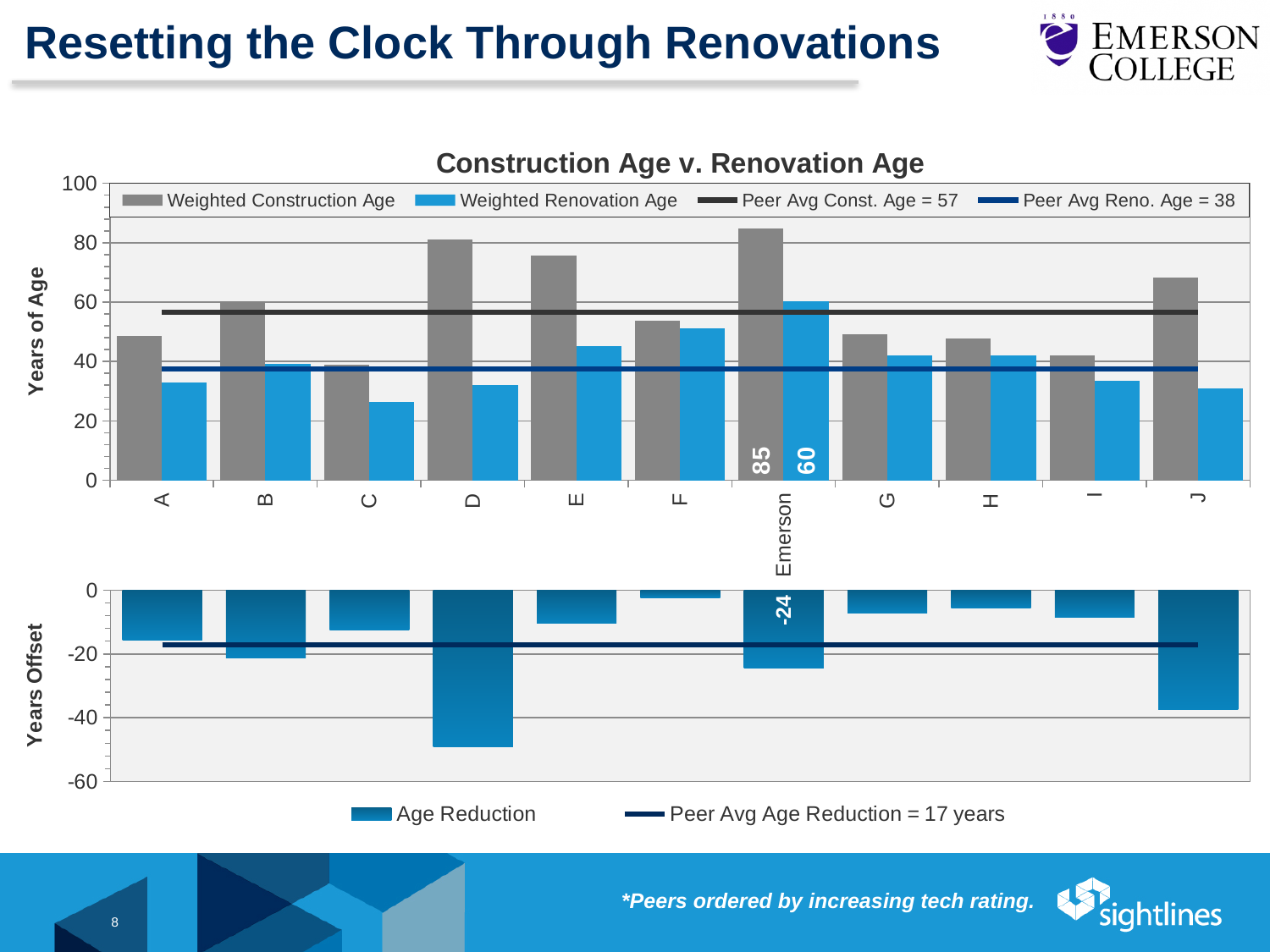
In the bottom chart (Years Offset), what is the Age Reduction value for Emerson? -24 In the top chart, Construction Age v. Renovation Age, what is the Weighted Construction Age for Emerson? 85 How many institutions are shown along the x axis of the top chart? 11 In the top chart, is the Weighted Construction Age for J greater or less than 60? greater In the top chart, what is the Peer Avg Const. Age shown in the legend? 57 In the top chart, Construction Age v. Renovation Age, what is the Weighted Renovation Age for Emerson? 60 In the top chart, is the Weighted Renovation Age for C greater or less than 40? less How many entries does the legend of the top chart list? 4 In the top chart, which institution has the lowest Weighted Construction Age? C In the top chart, which institution has the highest Weighted Renovation Age? Emerson In the bottom chart (Years Offset), which institution has the largest age reduction (most negative bar)? D In the top chart, what is the difference between Emerson's Weighted Construction Age and its Weighted Renovation Age? 25